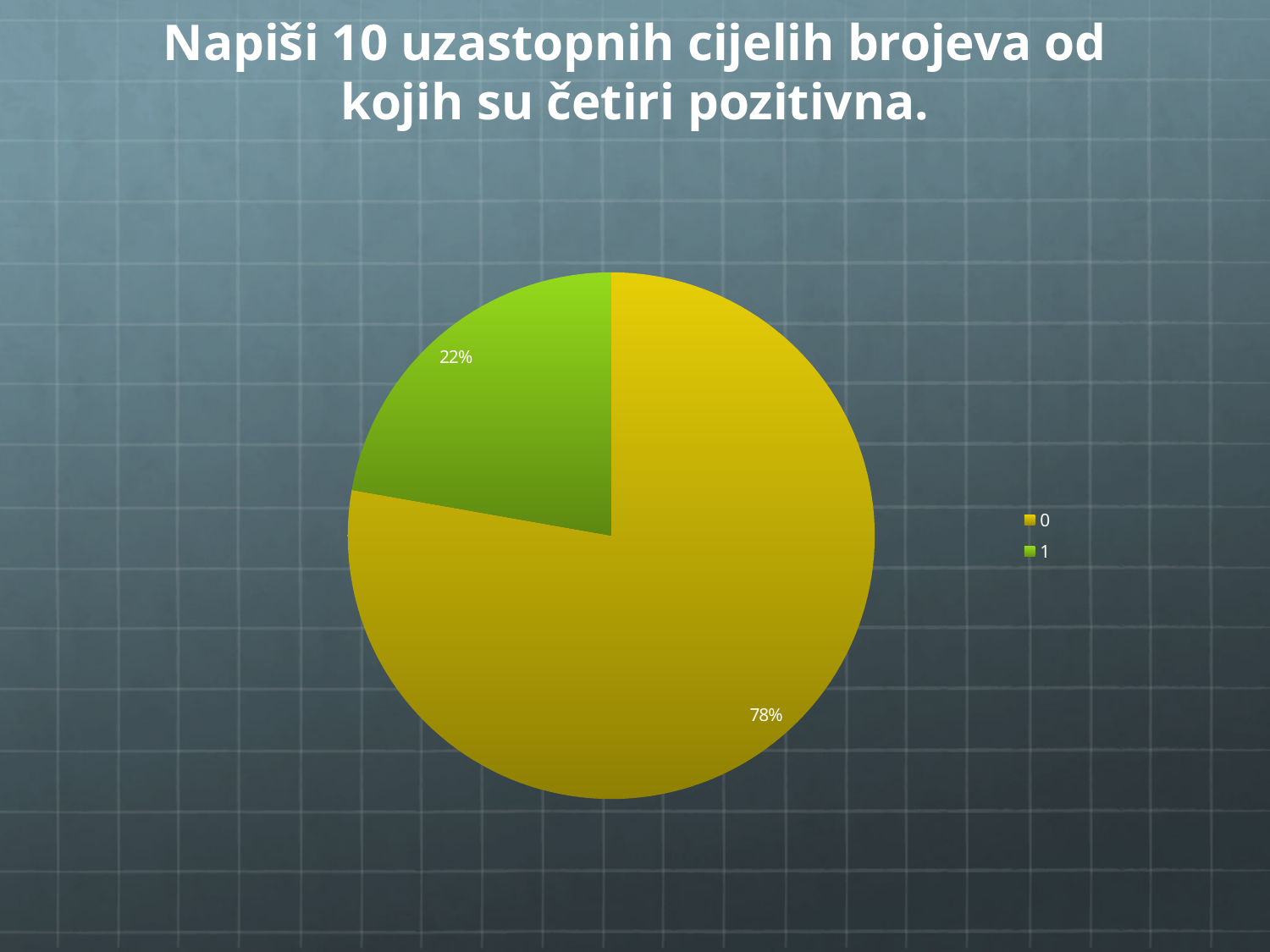
How many slices does the pie chart have? 2 Which category has the smallest slice of the pie? 1 What kind of chart is shown on the slide? pie chart What colour is the slice for category 0? yellow Which slice is larger, 0 or 1? 0 How many entries does the legend list? 2 What colour is the slice for category 1? green What share of the pie does category 1 have? 22% What is the difference in percentage points between the slices for 0 and 1? 56 Which category has the largest slice of the pie? 0 What share of the pie does category 0 have? 78%